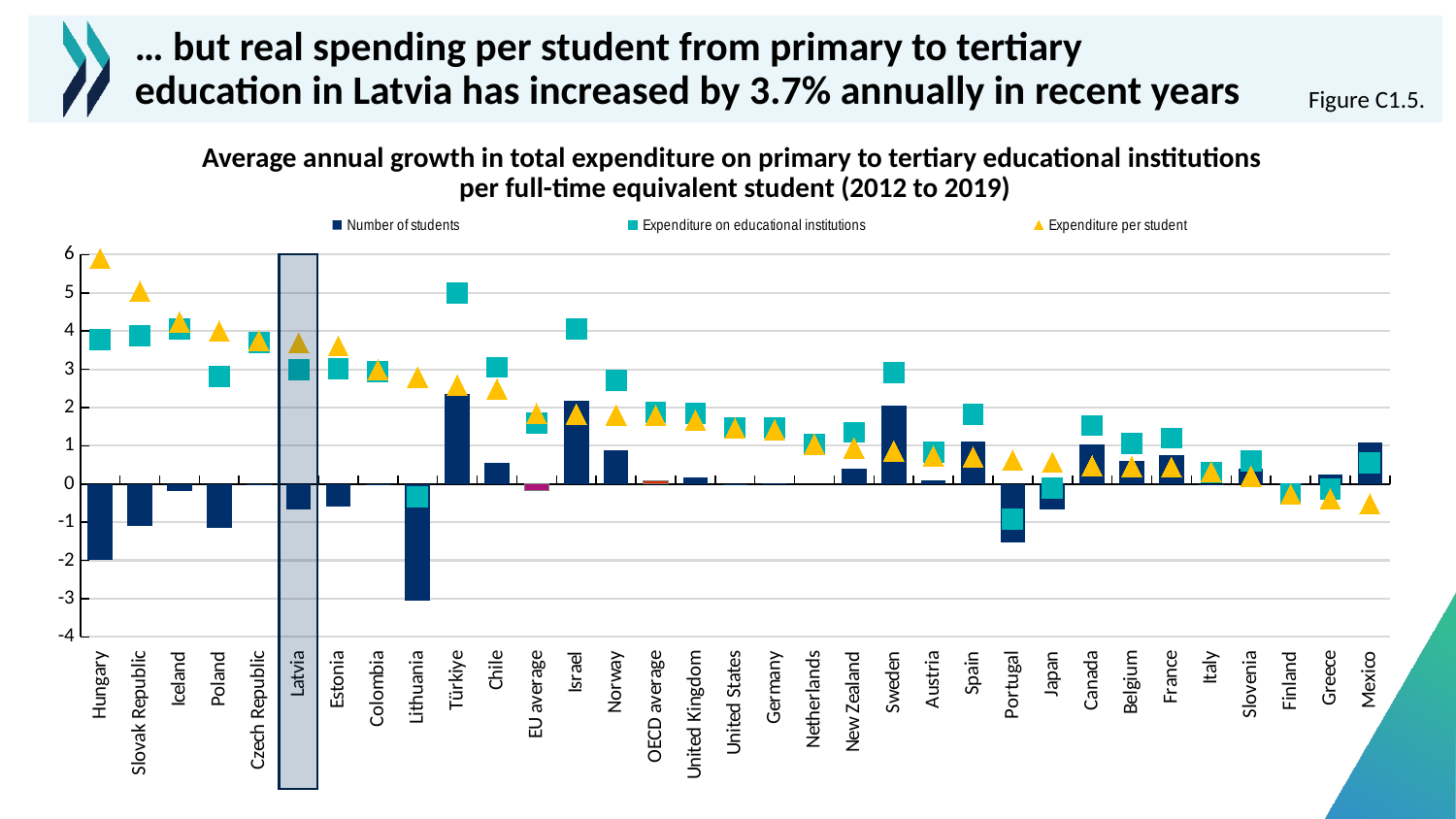
Which country has the highest value for Expenditure per student? Hungary Which has the larger Expenditure per student value, Hungary or Slovak Republic? Hungary Which country has the highest value for Expenditure on educational institutions? Türkiye Is the Expenditure per student value for Latvia greater or less than 3? greater Which country is highlighted with a shaded box on the chart? Latvia What kind of chart is shown on the slide? Bar chart with markers How many series does the legend list? 3 Is the Number of students value for Lithuania greater or less than -2? less Which country has the lowest value for Number of students? Lithuania How many countries or averages are shown along the x axis? 33 Is the Expenditure per student value for Hungary greater or less than 5? greater Do the Expenditure per student values generally rise or fall from left to right along the x axis? Fall